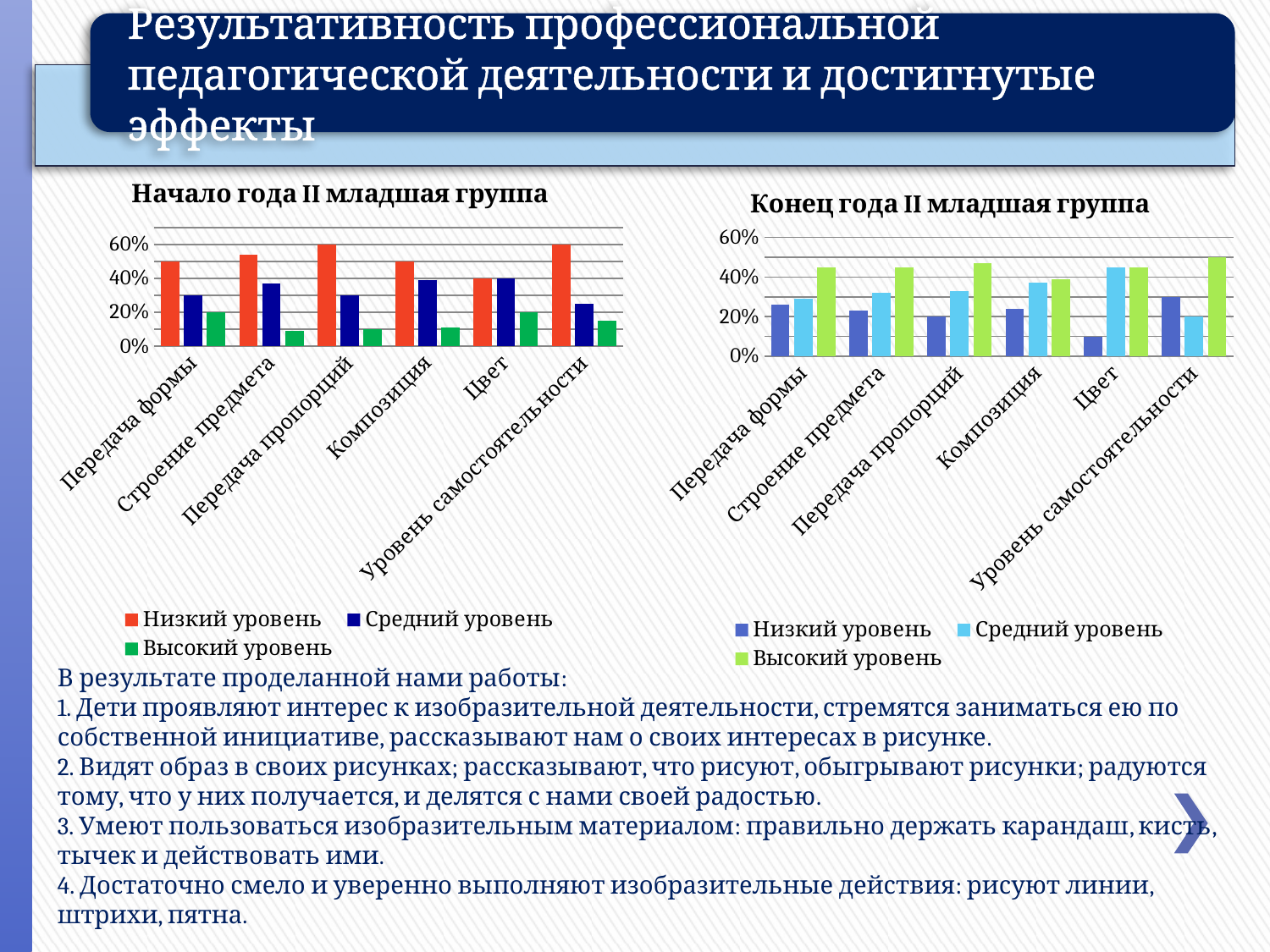
How many series does the legend of the right chart "Конец года II младшая группа" list? 3 In the right chart "Конец года II младшая группа", which is larger for "Передача формы": "Низкий уровень" or "Высокий уровень"? Высокий уровень In the left chart "Начало года II младшая группа", is the value of "Высокий уровень" for "Композиция" greater or less than 20%? less What kind of chart is the left chart titled "Начало года II младшая группа"? bar chart In the right chart "Конец года II младшая группа", is the value of "Низкий уровень" for "Цвет" greater or less than 20%? less In the left chart "Начало года II младшая группа", which is larger for "Передача пропорций": "Низкий уровень" or "Средний уровень"? Низкий уровень In the left chart "Начало года II младшая группа", what is the value of "Низкий уровень" for "Передача пропорций"? 60% What colour are the "Высокий уровень" bars in the right chart "Конец года II младшая группа"? light green How many categories are shown on the x axis of the left chart "Начало года II младшая группа"? 6 In the right chart "Конец года II младшая группа", is the value of "Высокий уровень" for "Уровень самостоятельности" greater or less than 40%? greater In the left chart "Начало года II младшая группа", what is the value of "Высокий уровень" for "Передача формы"? 20%